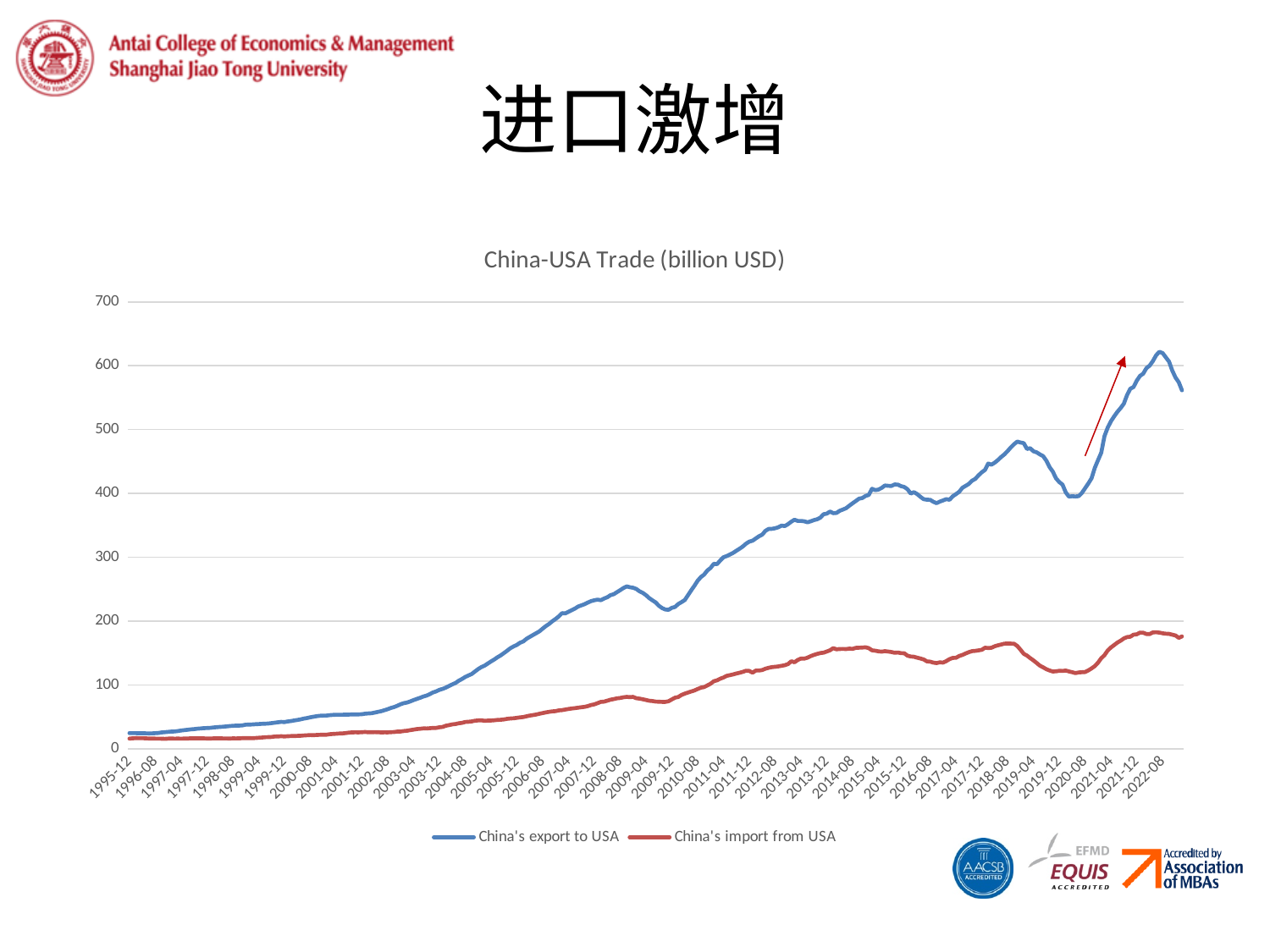
Which series reaches the highest value on the chart? China's export to USA At 2022-08, which is larger: China's export to USA or China's import from USA? China's export to USA What is the title of the chart? China-USA Trade (billion USD) Is the value for China's export to USA at 2022-08 greater or less than 500? greater How many series does the legend list? 2 Is the value for China's export to USA at 1995-12 greater or less than 100? less Overall, does China's export to USA rise or fall from 1995-12 to 2022-08? rise What kind of chart is shown on the slide? line chart Which series is drawn in blue? China's export to USA Is the value for China's import from USA at 2022-08 greater or less than 200? less Does China's import from USA ever exceed China's export to USA on the chart? No